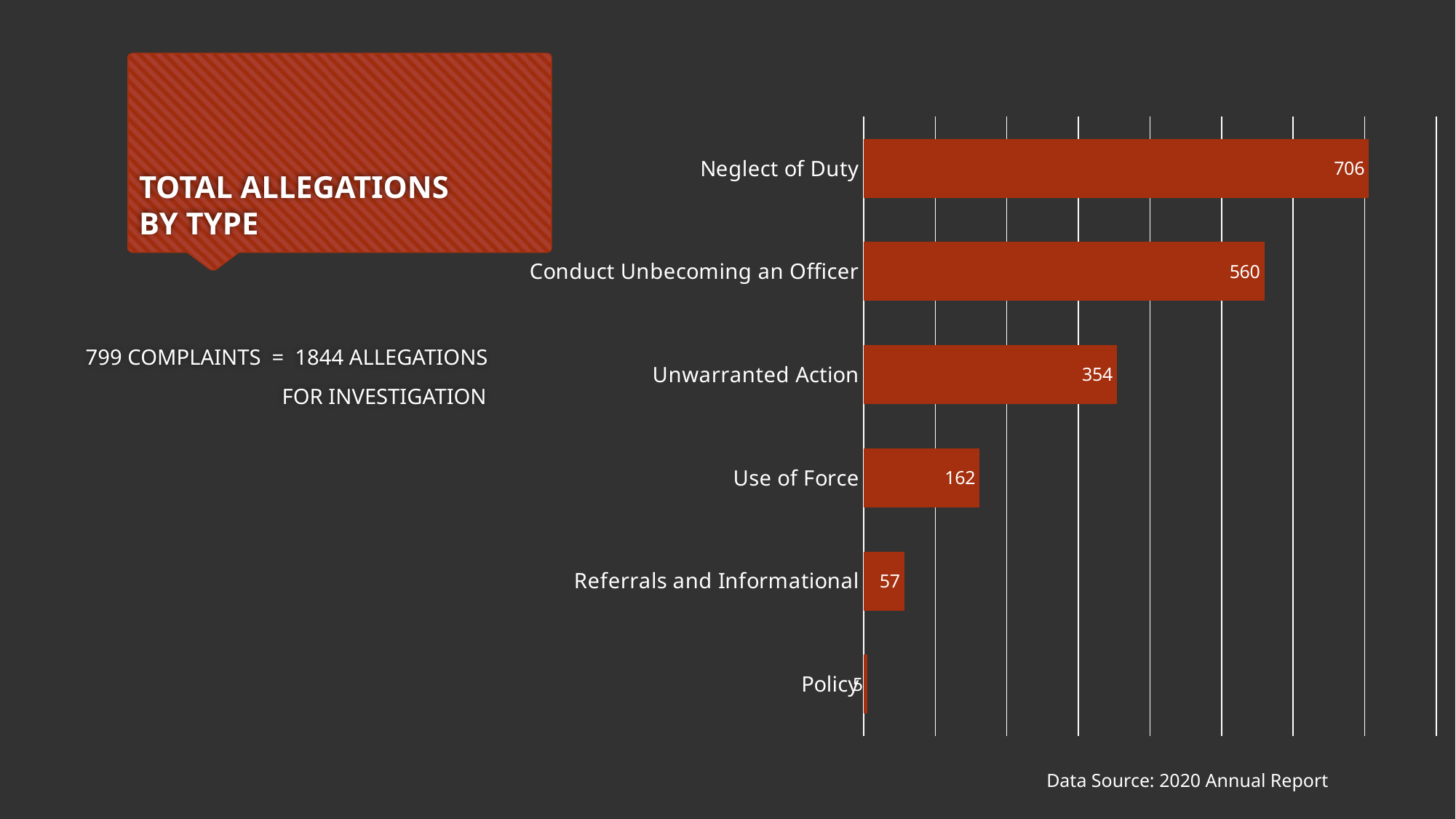
What is the value for Use of Force? 162 What is the title of the chart on the slide? Total Allegations by Type What kind of chart is shown on the slide? Bar chart What is the value for Unwarranted Action? 354 Which category has the lowest value? Policy What is the value for Neglect of Duty? 706 Which category has the highest value? Neglect of Duty How many categories are shown in the chart? 6 What is the difference between Neglect of Duty and Conduct Unbecoming an Officer? 146 Which is larger, Unwarranted Action or Use of Force? Unwarranted Action What is the value for Referrals and Informational? 57 What is the value for Conduct Unbecoming an Officer? 560